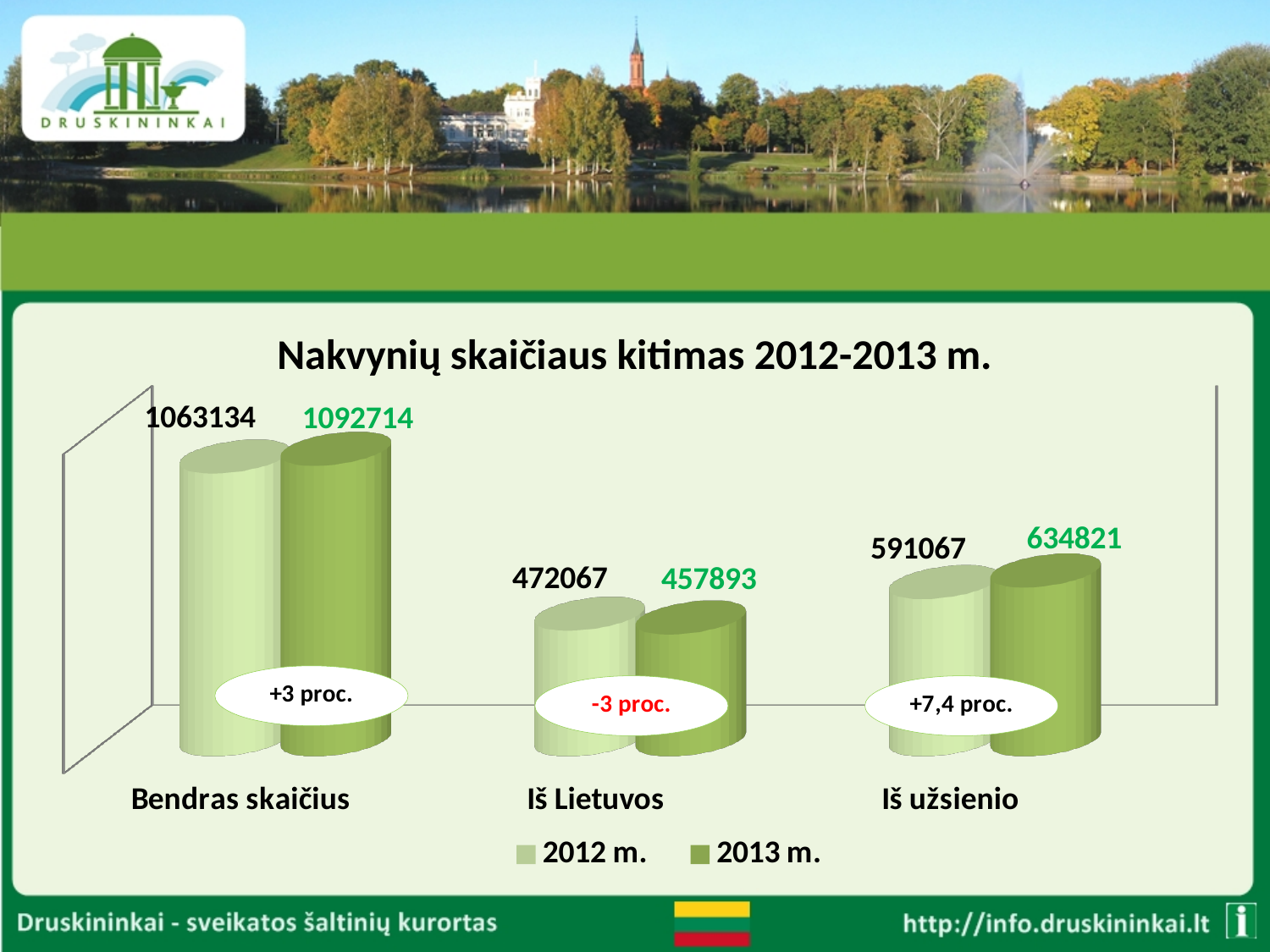
How many categories are shown on the x axis? 3 What is the value for 'Iš užsienio' in the 2012 m. series? 591067 Which category has the lowest value in the 2013 m. series? Iš Lietuvos What is the value for 'Bendras skaičius' in the 2013 m. series? 1092714 What kind of chart is shown on the slide? Bar chart What is the value for 'Iš Lietuvos' in the 2013 m. series? 457893 For 'Iš Lietuvos', which is larger: the 2012 m. value or the 2013 m. value? 2012 m. Which category has the highest value in the 2012 m. series? Bendras skaičius What is the difference between the 2013 m. and 2012 m. values for 'Iš užsienio'? 43754 What is the value for 'Bendras skaičius' in the 2012 m. series? 1063134 How many series does the legend list? 2 What percentage change is shown in the label for 'Iš užsienio'? +7,4 proc.